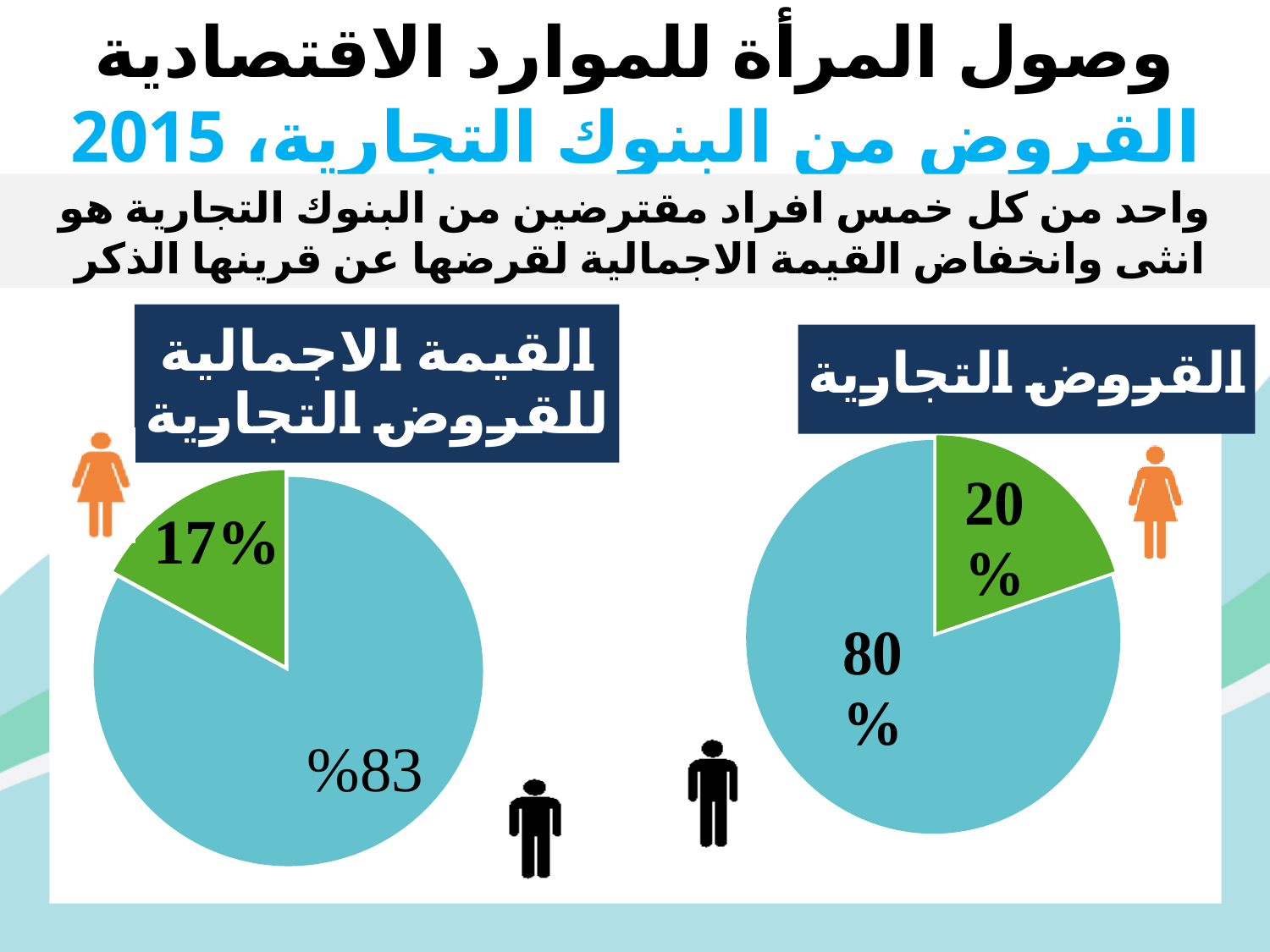
In the left-hand pie chart titled 'القيمة الاجمالية للقروض التجارية', what percentage does the green slice show? 17% How many pie charts are on the slide? 2 In the left-hand pie chart titled 'القيمة الاجمالية للقروض التجارية', what percentage does the blue slice show? 83% How many slices does each pie chart have? 2 In the left-hand pie chart, which slice is the smallest? The green slice (17%) In the right-hand pie chart titled 'القروض التجارية', what percentage does the green slice show? 20% In the left-hand pie chart, what is the difference between the blue slice and the green slice? 66% In the right-hand pie chart, which slice is larger, the green one or the blue one? The blue one In the right-hand pie chart titled 'القروض التجارية', what percentage does the blue slice show? 80% What kind of charts are shown on the slide? Pie charts In the right-hand pie chart, what is the difference between the blue slice and the green slice? 60% What year is mentioned in the slide title? 2015